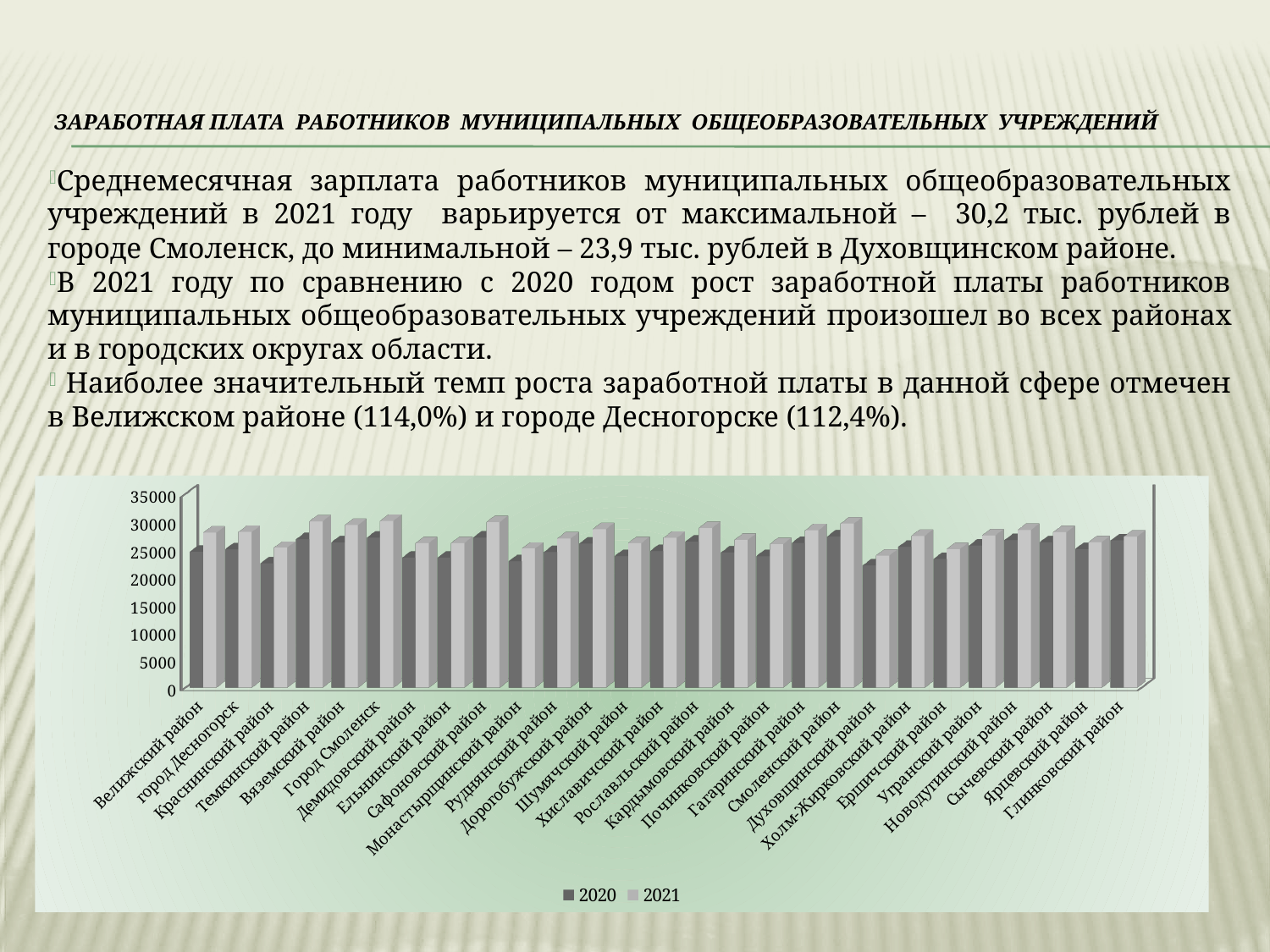
How many series does the chart legend list? 2 Is the 2021 value for Город Смоленск greater or less than 25000? greater What kind of chart is shown on the slide? bar chart For Город Смоленск, which is larger: the 2020 value or the 2021 value? 2021 Is the 2020 value for Темкинский район greater or less than 25000? greater What is the highest tick value shown on the vertical axis of the chart? 35000 Is the 2021 value for Велижский район greater or less than 20000? greater Which years are listed in the chart legend? 2020 and 2021 How many districts/cities are shown along the x axis of the chart? 27 For Велижский район, which is larger: the 2020 value or the 2021 value? 2021